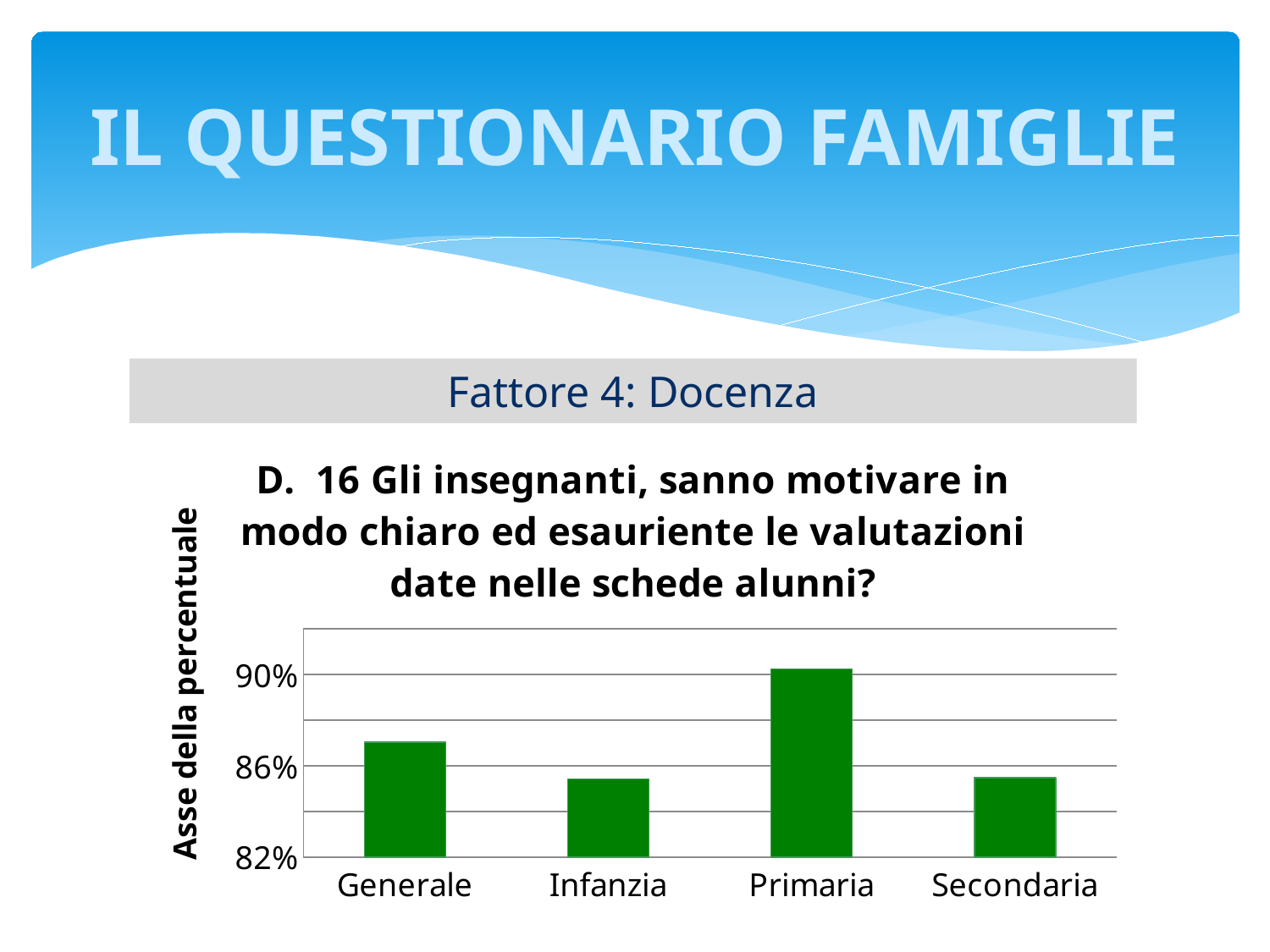
Is the value for Infanzia greater or less than 86%? less What kind of chart is shown on the slide? bar chart Which category has the highest value in the chart? Primaria Is the value for Generale greater or less than 86%? greater How many categories are shown on the x axis of the chart? 4 Is the value for Secondaria greater or less than 86%? less What is the label of the first category on the x axis of the chart? Generale Which is larger, the value for Generale or the value for Infanzia? Generale Which is larger, the value for Primaria or the value for Generale? Primaria What is the title of the vertical axis of the chart? Asse della percentuale